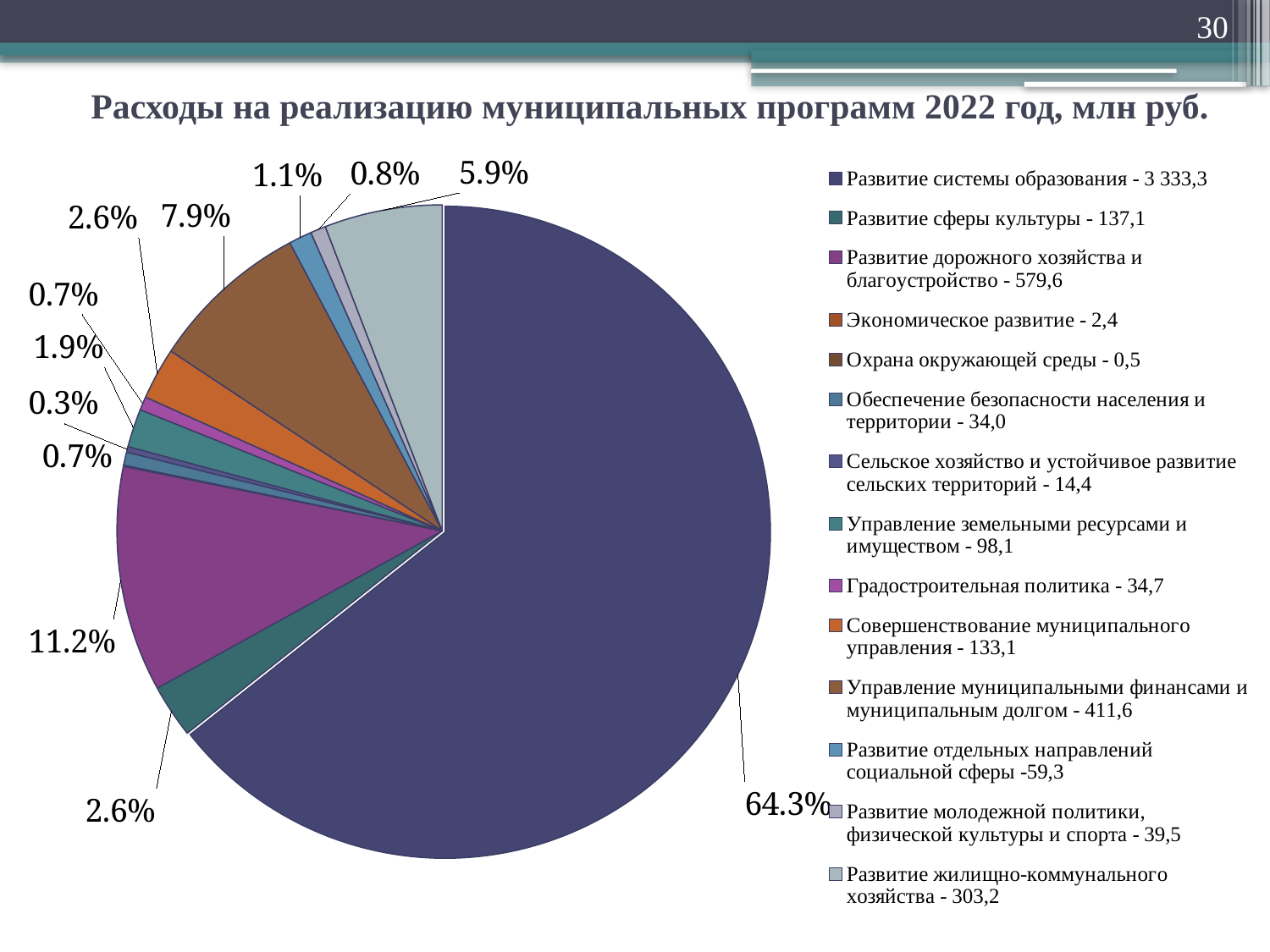
What share of the pie does 'Развитие системы образования' take? 64.3% What value (млн руб.) is given in the legend for 'Развитие дорожного хозяйства и благоустройство'? 579,6 What is the title of the chart on the slide? Расходы на реализацию муниципальных программ 2022 год, млн руб. Which category has the largest slice of the pie? Развитие системы образования Which is larger: the slice for 'Развитие системы образования' or the slice for 'Развитие дорожного хозяйства и благоустройство'? Развитие системы образования How many categories does the legend of the pie chart list? 14 What share of the pie does 'Развитие дорожного хозяйства и благоустройство' take? 11.2% What share of the pie does 'Развитие жилищно-коммунального хозяйства' take? 5.9% What is the difference in percentage points between the share of 'Развитие системы образования' (64.3%) and the share of 'Развитие дорожного хозяйства и благоустройство' (11.2%)? 53.1% What kind of chart is shown on the slide? pie chart What value (млн руб.) is given in the legend for 'Охрана окружающей среды'? 0,5